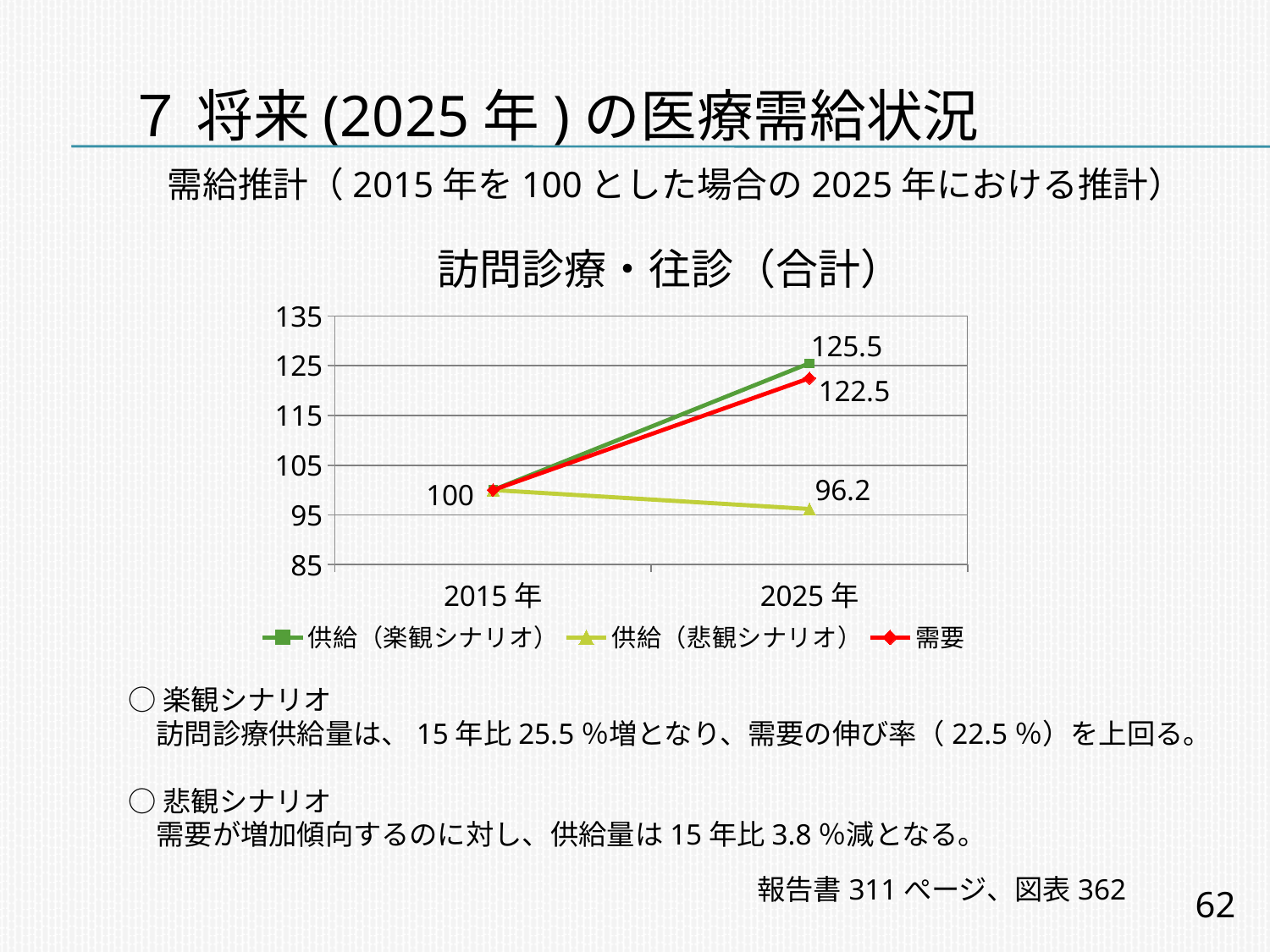
Which series has the highest value in 2025年? 供給（楽観シナリオ） What is the value of all series in 2015年? 100 What is the difference between 供給（楽観シナリオ） and 需要 in 2025年? 3 Which series has the lowest value in 2025年? 供給（悲観シナリオ） What is the value of 供給（悲観シナリオ） in 2025年? 96.2 What is the value of 需要 in 2025年? 122.5 How many series does the legend list? 3 Does the 供給（悲観シナリオ） series rise or fall from 2015年 to 2025年? fall How many points are on the x axis? 2 What is the value of 供給（楽観シナリオ） in 2025年? 125.5 What is the chart's title? 訪問診療・往診（合計） What type of chart is shown on the slide? line chart